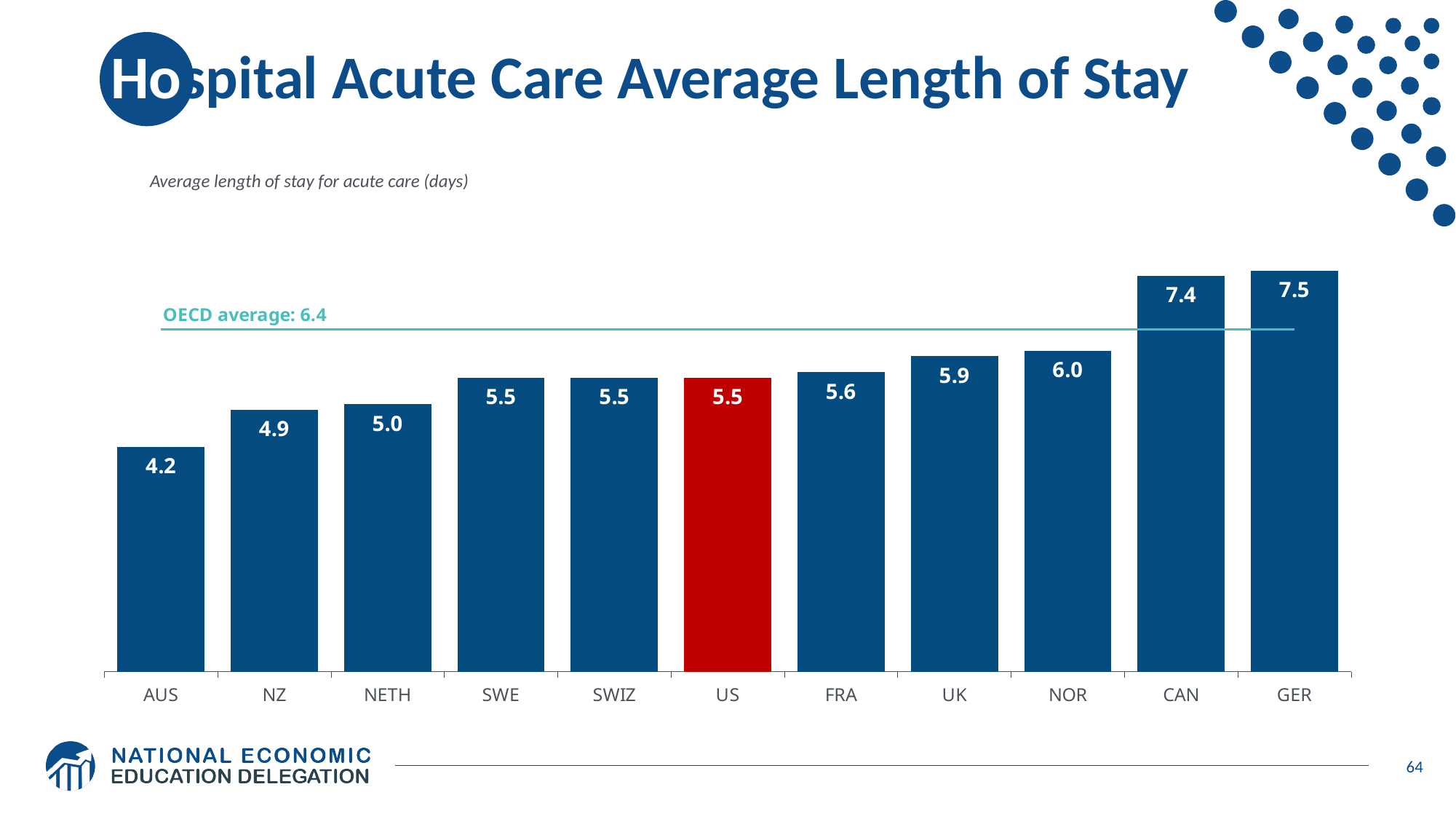
Which country has the lowest average length of stay? AUS How many countries are shown in the chart? 11 Which country has the highest average length of stay? GER Do the values generally rise or fall from left to right across the countries? Rise What is the average length of stay for acute care in Canada (CAN)? 7.4 What OECD average value is marked by the horizontal line on the chart? 6.4 Which has a longer average length of stay, UK or FRA? UK What is the difference between the values for NOR and NZ? 1.1 What is the difference between the values for GER and AUS? 3.3 What kind of chart is shown on the slide? Bar chart What is the value shown for AUS? 4.2 What is the average length of stay for acute care in the US? 5.5